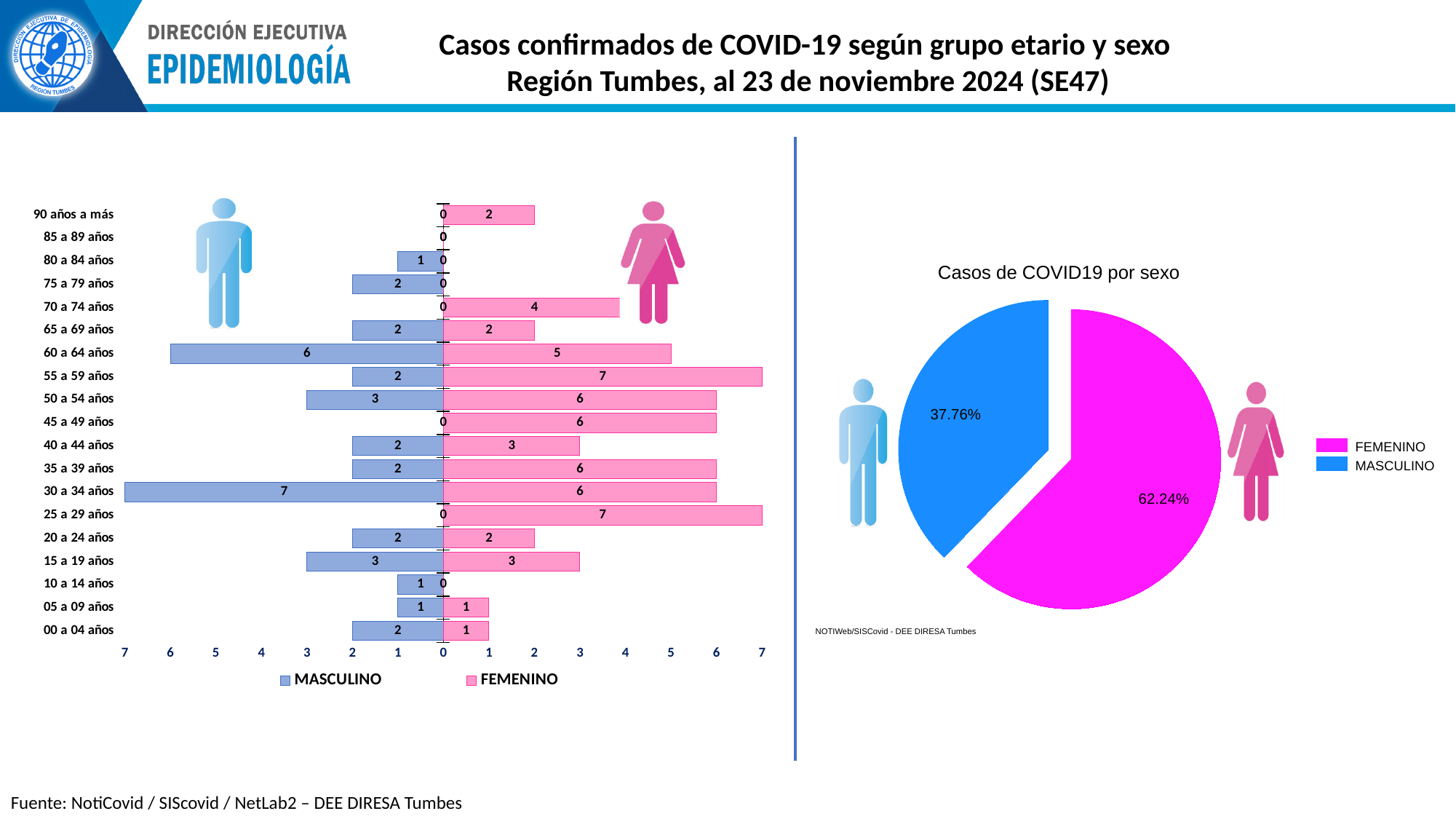
In the left bar chart, how many FEMENINO cases are shown for the 70 a 74 años age group? 4 How many series does the legend of the left chart list? 2 In the pie chart 'Casos de COVID19 por sexo', what share of cases is FEMENINO? 62.24% How many age groups are listed in the left bar chart? 19 In the pie chart 'Casos de COVID19 por sexo', what share of cases is MASCULINO? 37.76% In the left bar chart, how many MASCULINO cases are shown for the 30 a 34 años age group? 7 In the left bar chart, which age group has the highest number of MASCULINO cases? 30 a 34 años What type of chart is the chart titled 'Casos de COVID19 por sexo'? Pie chart In the left bar chart, what is the difference between FEMENINO and MASCULINO cases in the 50 a 54 años age group? 3 In the left bar chart, how many FEMENINO cases are shown for the 55 a 59 años age group? 7 In the left bar chart, what is the total number of cases (MASCULINO plus FEMENINO) for the 15 a 19 años age group? 6 In the left bar chart, which is larger for the 60 a 64 años age group, MASCULINO or FEMENINO cases? MASCULINO